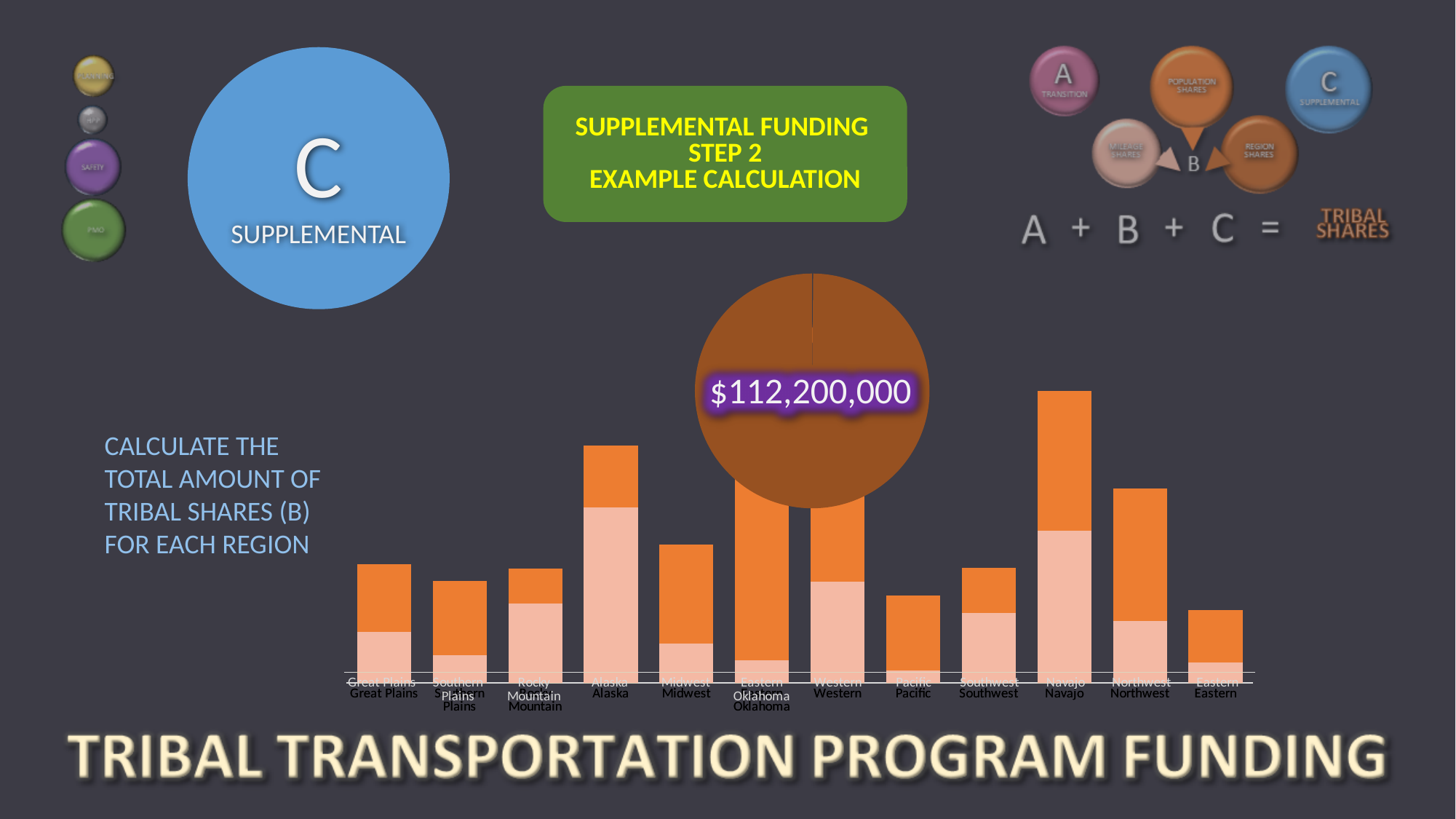
What kind of chart shows the regions such as Great Plains, Alaska and Navajo? bar chart How many coloured segments make up each bar in the bar chart? 2 In the bar chart, which bar is taller, Navajo or Alaska? Navajo In the bar chart, which bar is taller, Northwest or Southwest? Northwest What is the name of the region whose bar is immediately to the right of Alaska in the bar chart? Midwest In the bar chart, which region has the larger light-coloured (bottom) segment, Alaska or Navajo? Alaska How many regions are shown on the x axis of the bar chart? 12 Which region has the shortest bar in the bar chart? Eastern What value is labelled on the circular (pie) chart above the bar chart? $112,200,000